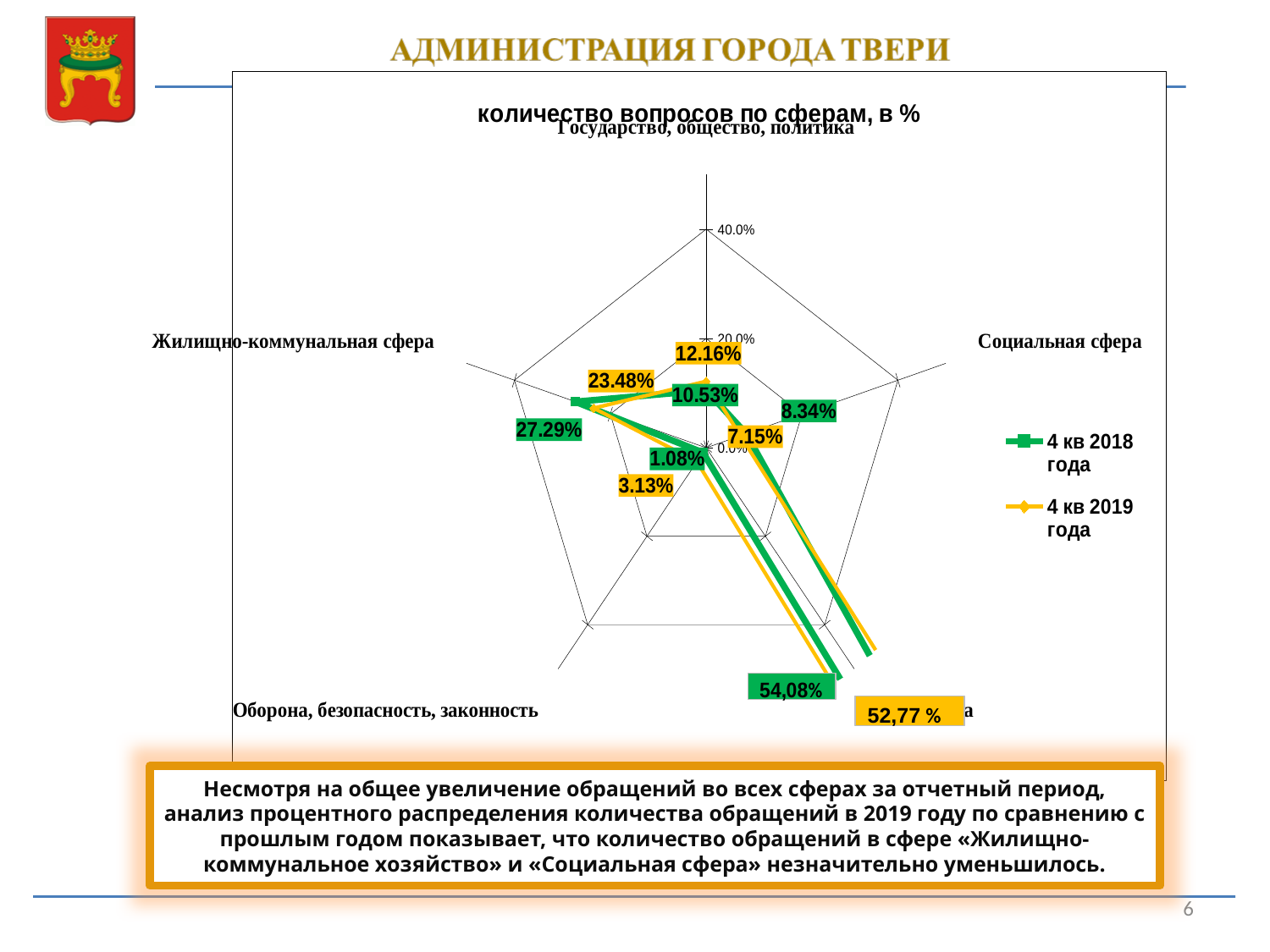
What is the value for Жилищно-коммунальная сфера in the 4 кв 2019 года series? 23.48% What is the value for Социальная сфера in the 4 кв 2018 года series? 8.34% How many series does the chart legend list? 2 What is the value for Жилищно-коммунальная сфера in the 4 кв 2018 года series? 27.29% What is the value for Государство, общество, политика in the 4 кв 2019 года series? 12.16% What is the title of the chart? количество вопросов по сферам, в % What kind of chart is shown on the slide? radar chart What is the value for Оборона, безопасность, законность in the 4 кв 2018 года series? 1.08% What is the value for Социальная сфера in the 4 кв 2019 года series? 7.15% How many axes (categories) does the radar chart have? 5 Which series has the larger value for Жилищно-коммунальная сфера, 4 кв 2018 года or 4 кв 2019 года? 4 кв 2018 года